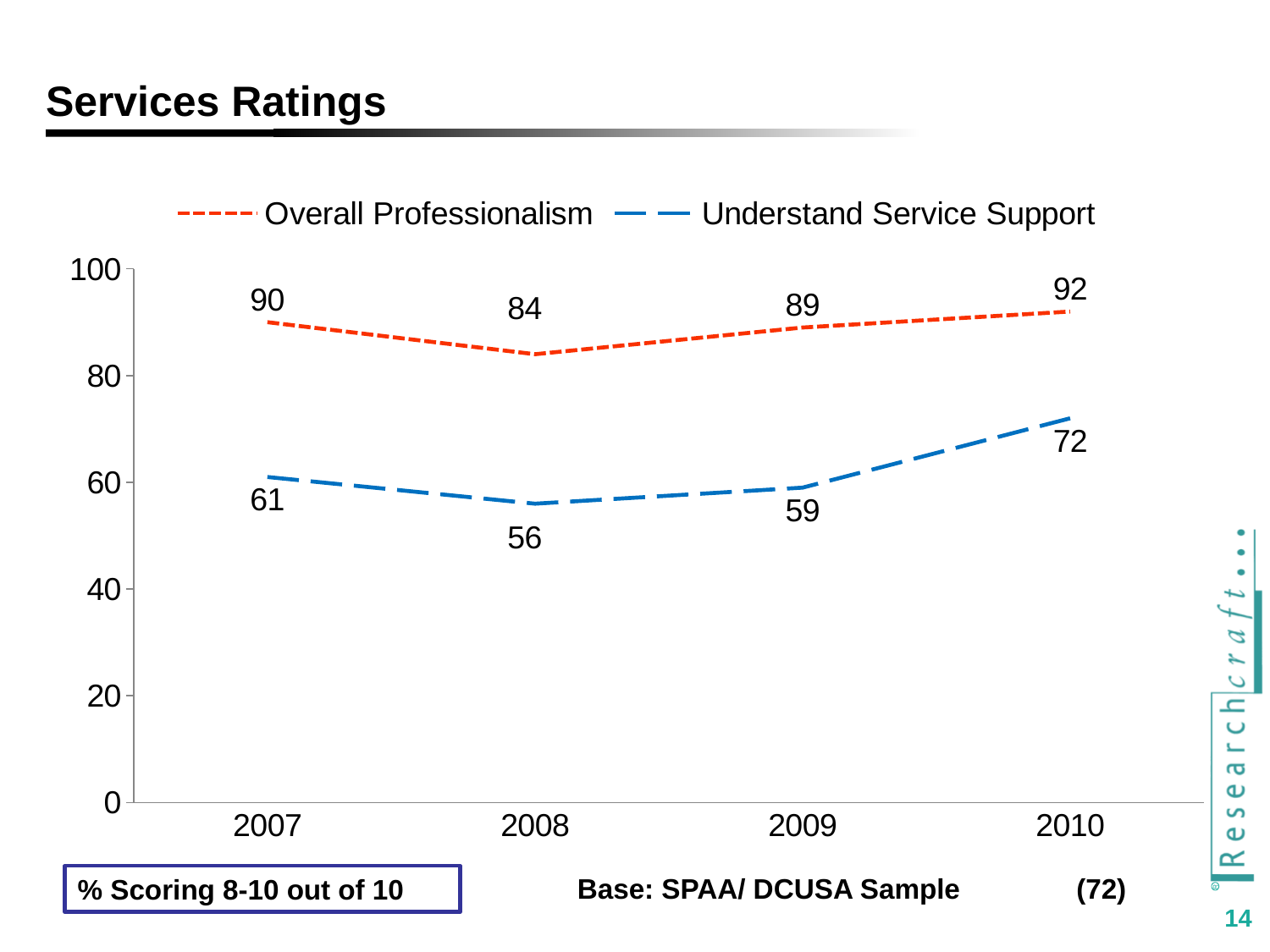
By how much did Understand Service Support change from 2009 to 2010? 13 In which year is Understand Service Support lowest? 2008 What is the difference between Overall Professionalism and Understand Service Support in 2009? 30 What is the value for Overall Professionalism in 2008? 84 What kind of chart is shown on the slide? Line chart What is the value for Understand Service Support in 2007? 61 How many years are shown on the x axis? 4 Which is larger in 2007: Overall Professionalism or Understand Service Support? Overall Professionalism How many series does the legend list? 2 What is the value for Understand Service Support in 2010? 72 In which year is Overall Professionalism highest? 2010 Does Understand Service Support rise or fall from 2008 to 2010? Rise